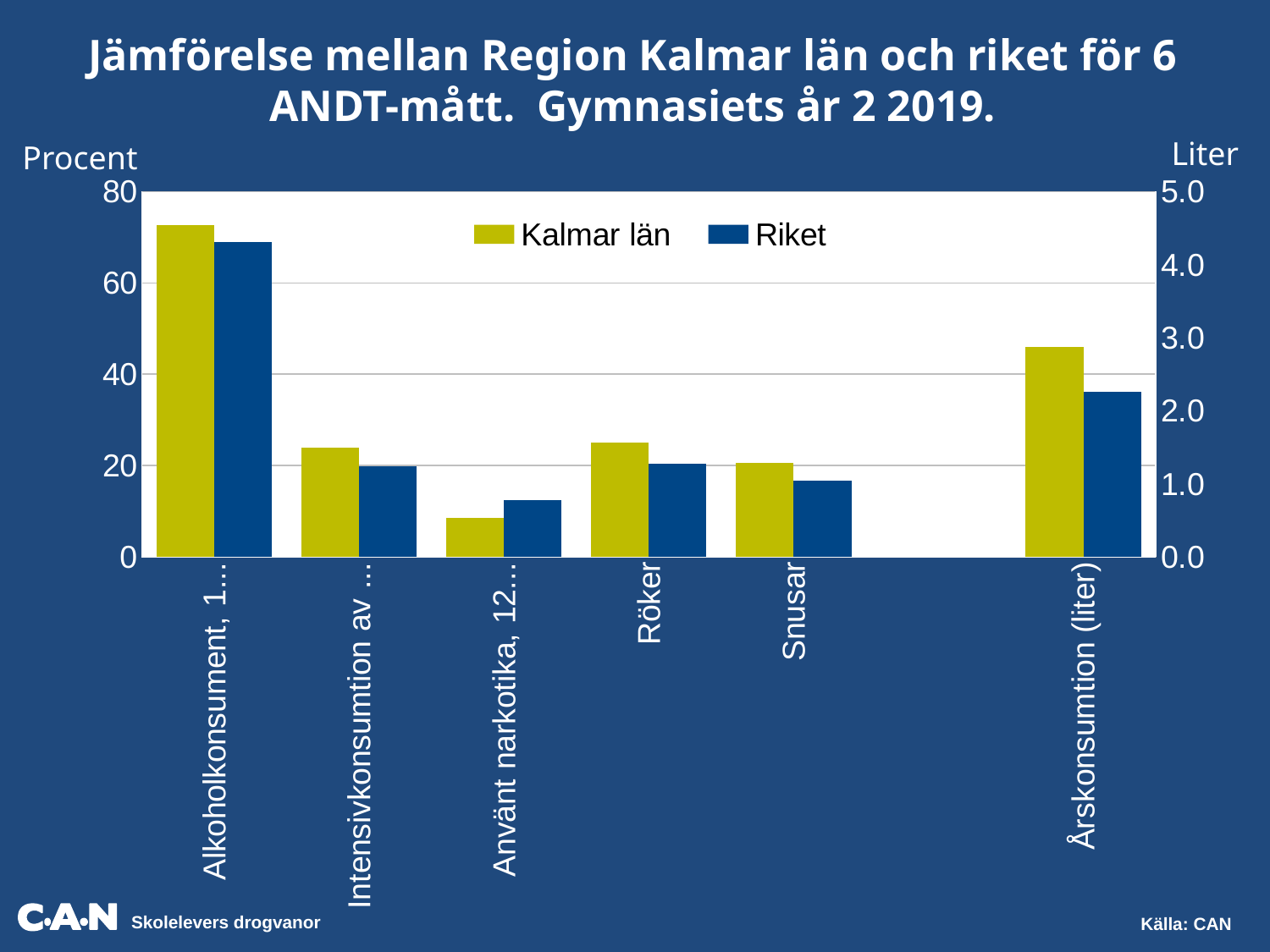
For Årskonsumtion (liter), which is larger: Kalmar län or Riket? Kalmar län Is the Kalmar län value for Röker greater or less than 20? greater Which two series are listed in the legend? Kalmar län and Riket Is the Riket value for Snusar greater or less than 20? less Which category has the highest Kalmar län value on the percent axis? Alkoholkonsument How many series does the legend list? 2 What kind of chart is shown on the slide? Bar chart What unit is shown on the right-hand axis? Liter Is the Kalmar län value for Årskonsumtion (liter) greater or less than 2.0? greater For Röker, which is larger: Kalmar län or Riket? Kalmar län How many categories are shown on the x axis? 6